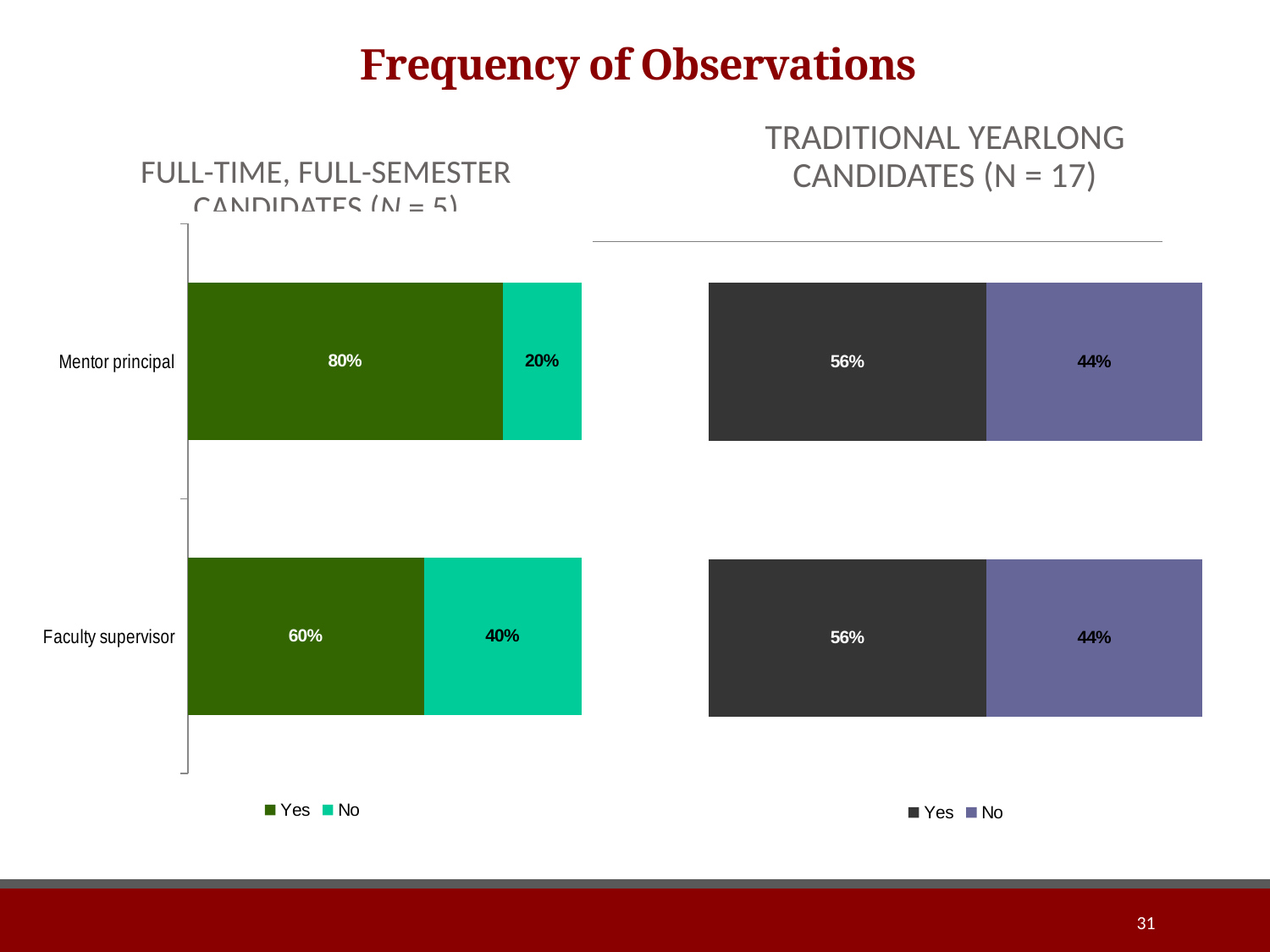
In the Full-Time, Full-Semester Candidates chart, what is the difference between the Yes values for Mentor principal and Faculty supervisor? 20% How many series does the legend of the Traditional Yearlong Candidates chart list? 2 In the Full-Time, Full-Semester Candidates chart, which category has the higher Yes value? Mentor principal What type of chart is the Traditional Yearlong Candidates chart? Stacked bar chart In the Full-Time, Full-Semester Candidates chart, what percentage of Faculty supervisor responses were No? 40% In the Traditional Yearlong Candidates chart, what is the difference between the Yes and No values in the top bar? 12% In the Traditional Yearlong Candidates chart, what is the Yes value for the top bar? 56% In the Traditional Yearlong Candidates chart, what is the No value for the bottom bar? 44% How many categories are shown in the Full-Time, Full-Semester Candidates chart? 2 In the Full-Time, Full-Semester Candidates chart, what is the No value for Mentor principal? 20% In the Full-Time, Full-Semester Candidates chart, what percentage of Mentor principal responses were Yes? 80% In the Full-Time, Full-Semester Candidates chart, is the Yes value for Faculty supervisor larger or smaller than the No value? larger